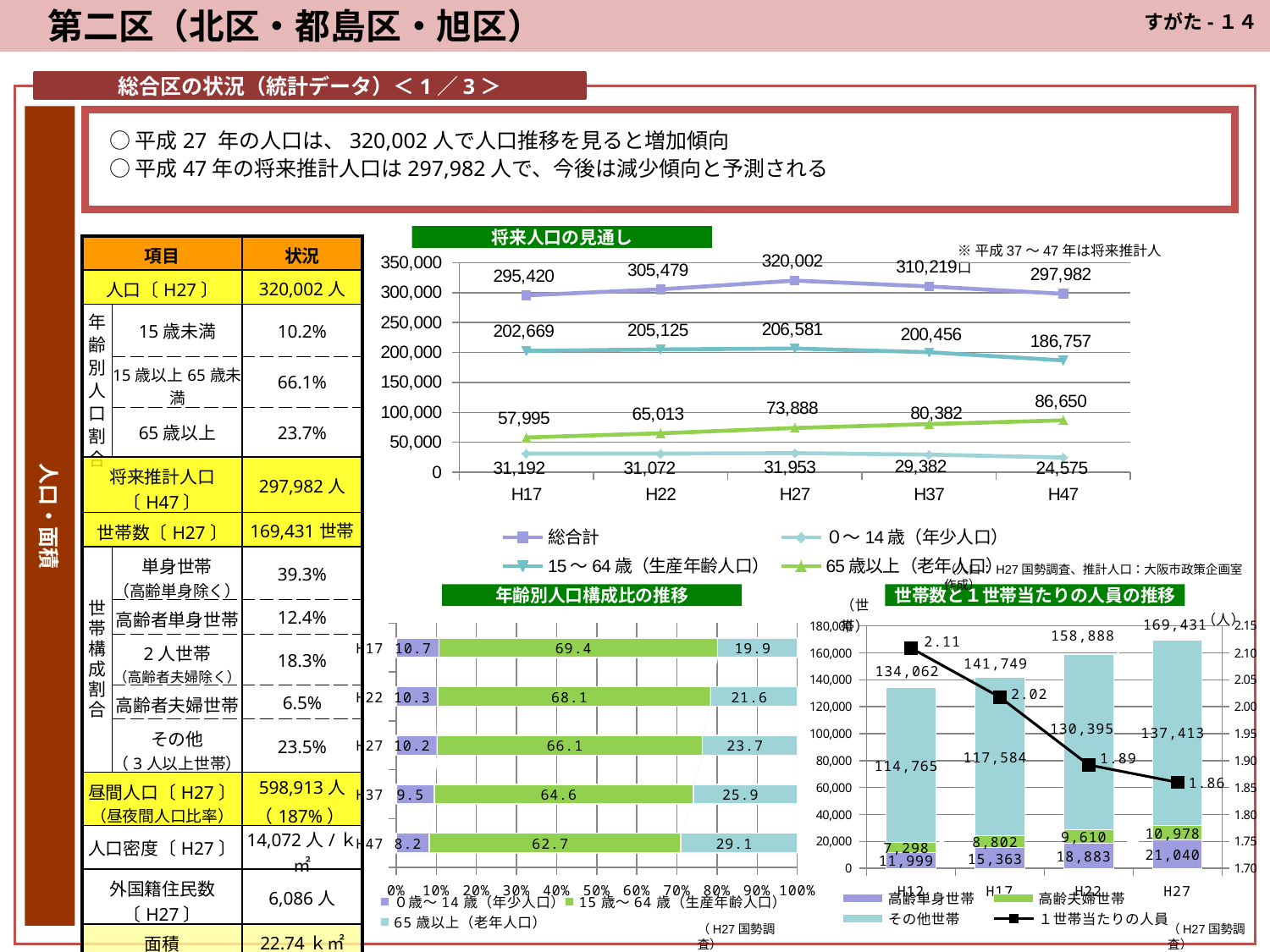
In the 世帯数と1世帯当たりの人員の推移 chart, what is the その他世帯 value for H22? 130,395 How many series does the legend of the 将来人口の見通し chart list? 4 In the 年齢別人口構成比の推移 chart, what is the 15歳～64歳（生産年齢人口） share for H37? 64.6 In the 将来人口の見通し chart, what is the difference between the 15～64歳（生産年齢人口） values for H27 and H47? 19,824 In the 将来人口の見通し chart, which year has the highest 総合計 value? H27 In the 年齢別人口構成比の推移 chart, which year has the lowest 0歳～14歳（年少人口） share? H47 In the 将来人口の見通し chart, what is the 総合計 value for H27? 320,002 In the 世帯数と1世帯当たりの人員の推移 chart, is the 1世帯当たりの人員 value for H12 larger or smaller than for H27? larger In the 世帯数と1世帯当たりの人員の推移 chart, what is the total number of households for H27? 169,431 In the 将来人口の見通し chart, what is the 65歳以上（老年人口） value for H47? 86,650 What kind of chart is the 年齢別人口構成比の推移 chart? bar chart In the 将来人口の見通し chart, does the 65歳以上（老年人口） series rise or fall from H17 to H47? rise